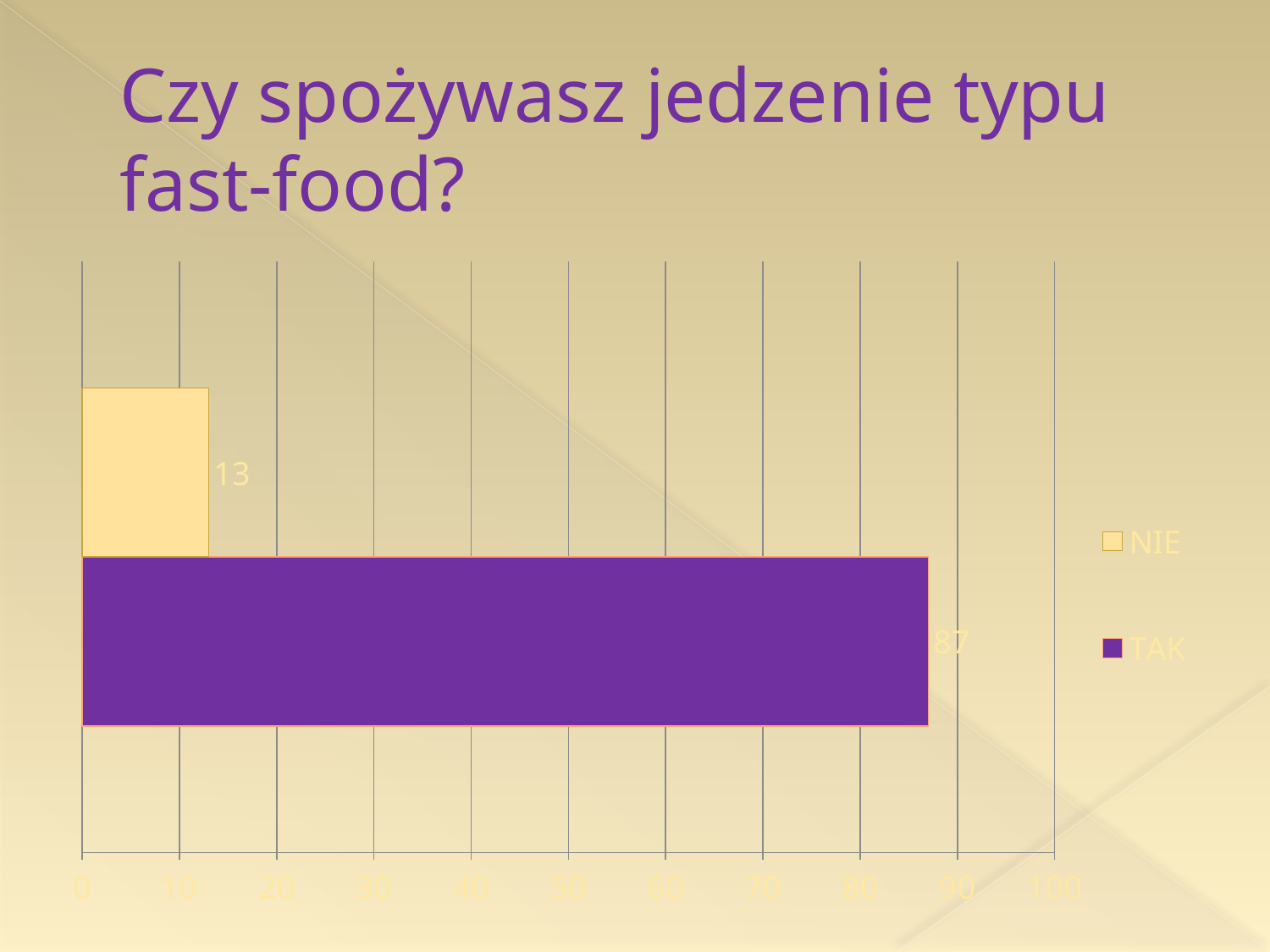
What is the title of the slide? Czy spożywasz jedzenie typu fast-food? Which is larger, the value for TAK or the value for NIE? TAK What is the total of the TAK and NIE values? 100 How many series does the legend list? 2 Is the value for TAK greater or less than 80? greater Which series has the highest value? TAK What is the difference between the values for TAK and NIE? 74 Which series has the lowest value? NIE What is the value for NIE? 13 Is the value for NIE greater or less than 20? less What kind of chart is shown on the slide? bar chart What is the value for TAK? 87